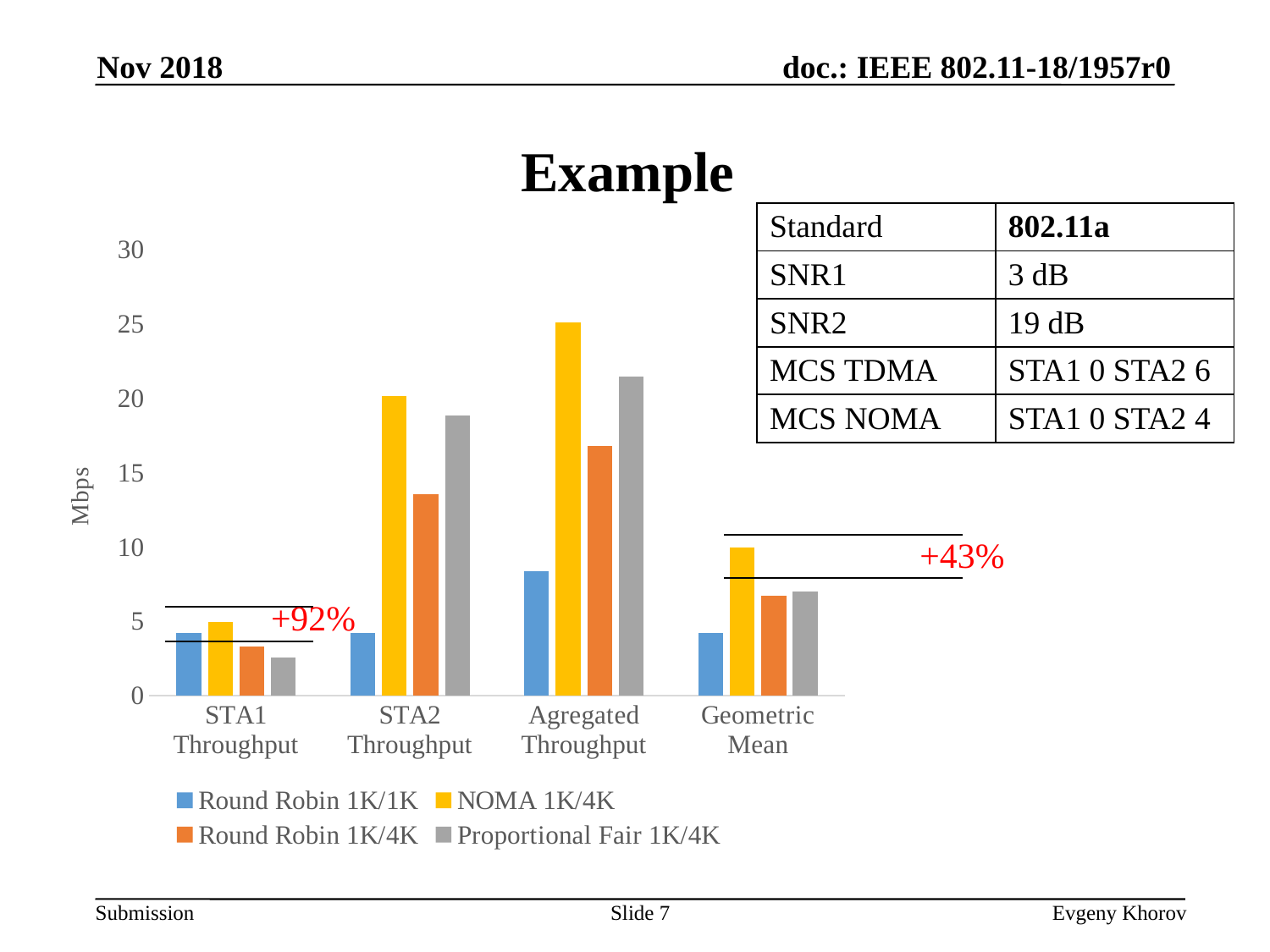
What unit is shown on the y axis of the chart? Mbps Is the Aggregated Throughput for Proportional Fair 1K/4K greater or less than 20? greater Is the STA2 Throughput for Round Robin 1K/4K greater or less than 15? less For STA2 Throughput, which is larger: NOMA 1K/4K or Proportional Fair 1K/4K? NOMA 1K/4K How many categories are shown on the x axis of the chart? 4 Which series has the lowest STA2 Throughput? Round Robin 1K/1K What percentage gain is annotated above the Geometric Mean bars? +43% How many series does the chart legend list? 4 Which series has the highest Aggregated Throughput? NOMA 1K/4K Which series has the lowest STA1 Throughput? Proportional Fair 1K/4K What kind of chart is shown on the slide? bar chart